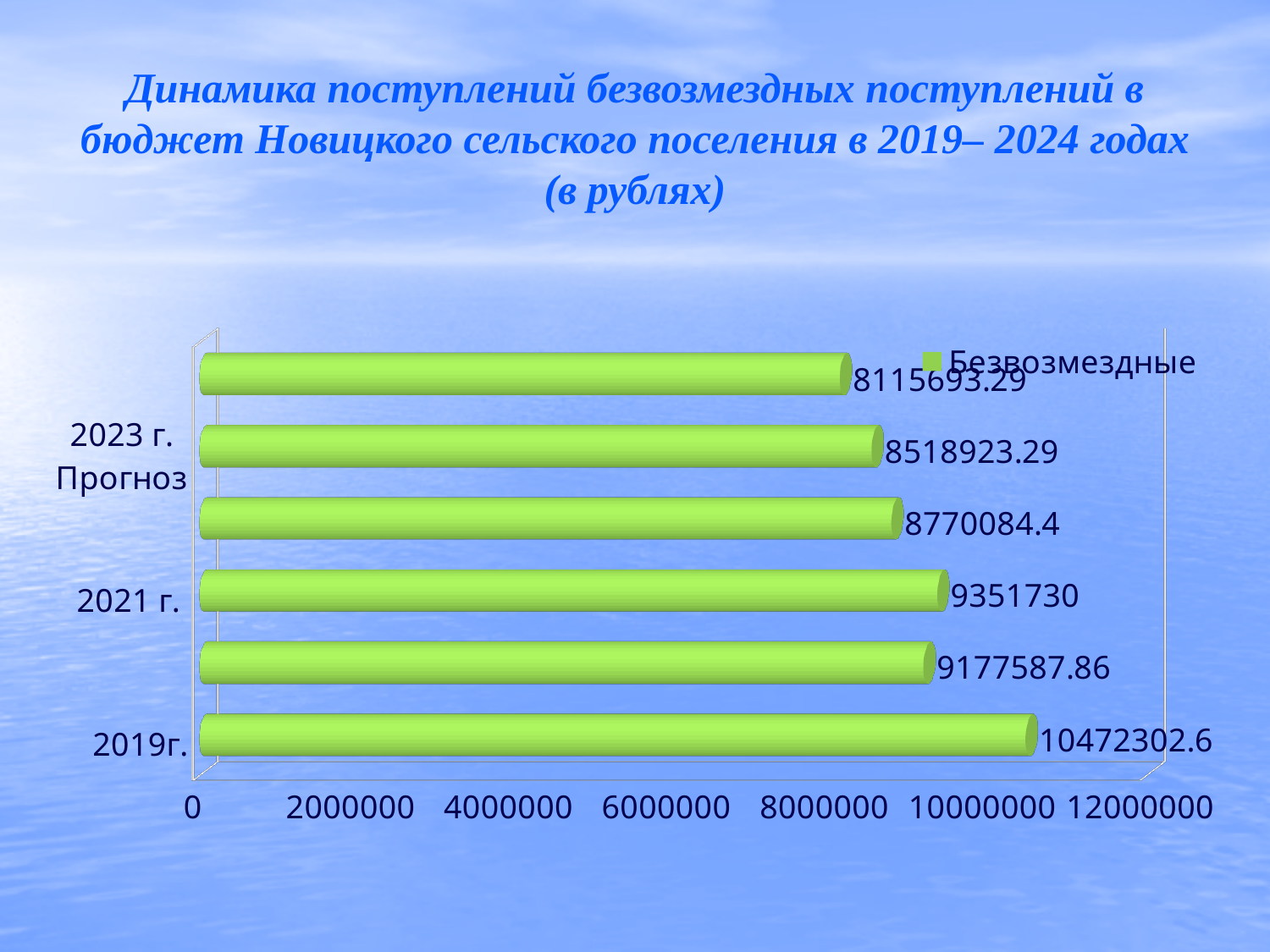
What is the value for 2019г.? 10472302.6 How many series does the legend list? 1 What kind of chart is shown on the slide? bar chart What is the difference between the values for 2021 г. and 2023 г. Прогноз? 832806.71 Is the value for 2023 г. Прогноз greater or less than 10000000? less What is the difference between the values for 2019г. and 2021 г.? 1120572.6 What is the value for 2023 г. Прогноз? 8518923.29 Which is larger, the value for 2019г. or the value for 2021 г.? 2019г. What is the name of the series shown in the legend? Безвозмездные What is the value for 2021 г.? 9351730 How many bars are plotted in the chart? 6 Which category has the highest value? 2019г.